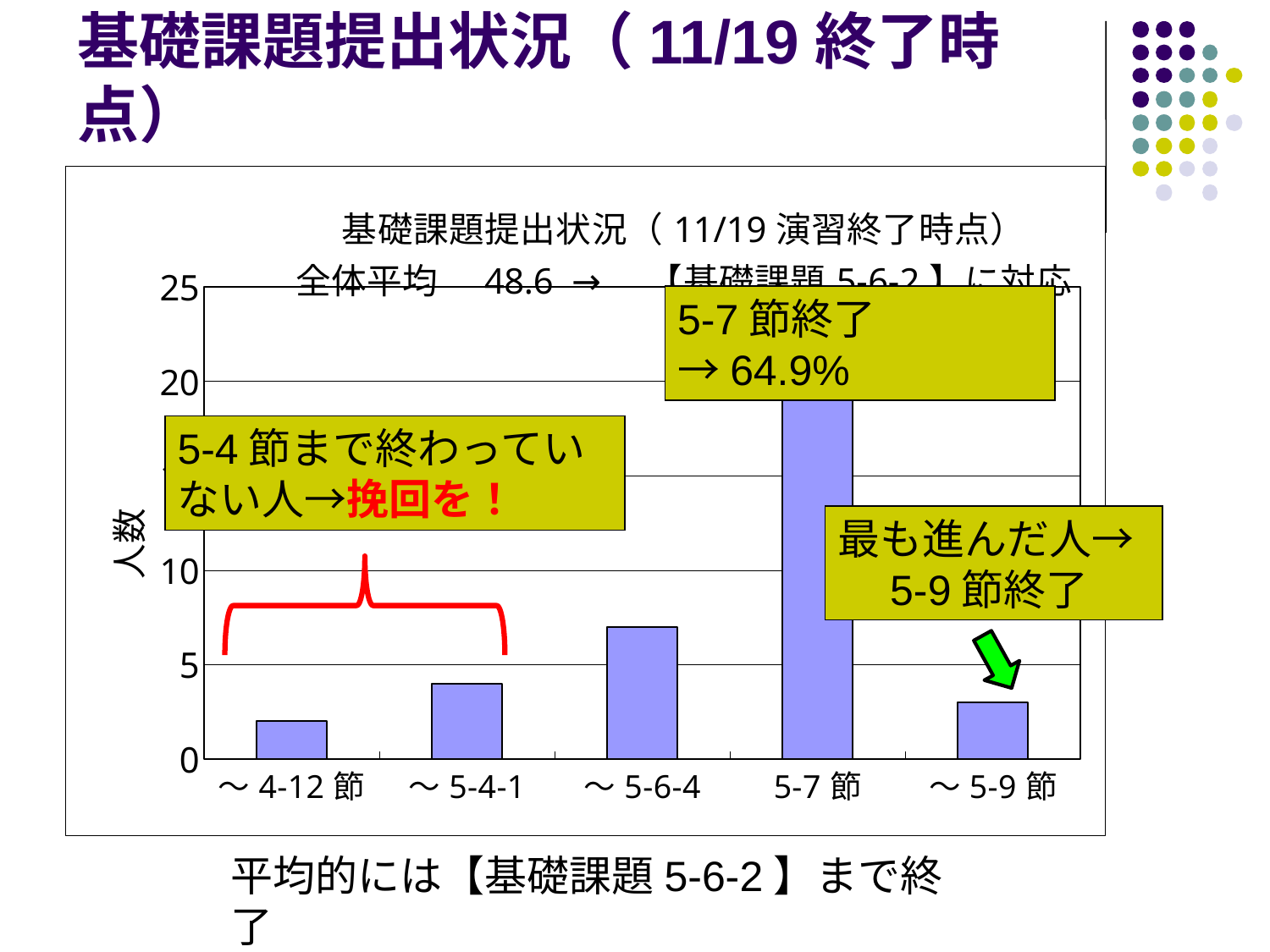
What is the title of the chart? 基礎課題提出状況（11/19 演習終了時点） 全体平均 48.6 → 【基礎課題 5-6-2】に対応 Is the value for ～4-12 節 greater or less than 5? less Is the value for ～5-6-4 greater or less than 5? greater Which category has the highest bar in the chart? 5-7 節 What kind of chart is shown on the slide? bar chart Which is larger, the value for ～5-6-4 or the value for ～5-4-1? ～5-6-4 Is the value for ～5-6-4 greater or less than 10? less How many categories are shown on the x axis of the chart? 5 What is the label of the y axis of the chart? 人数 Which is larger, the value for 5-7 節 or the value for ～5-9 節? 5-7 節